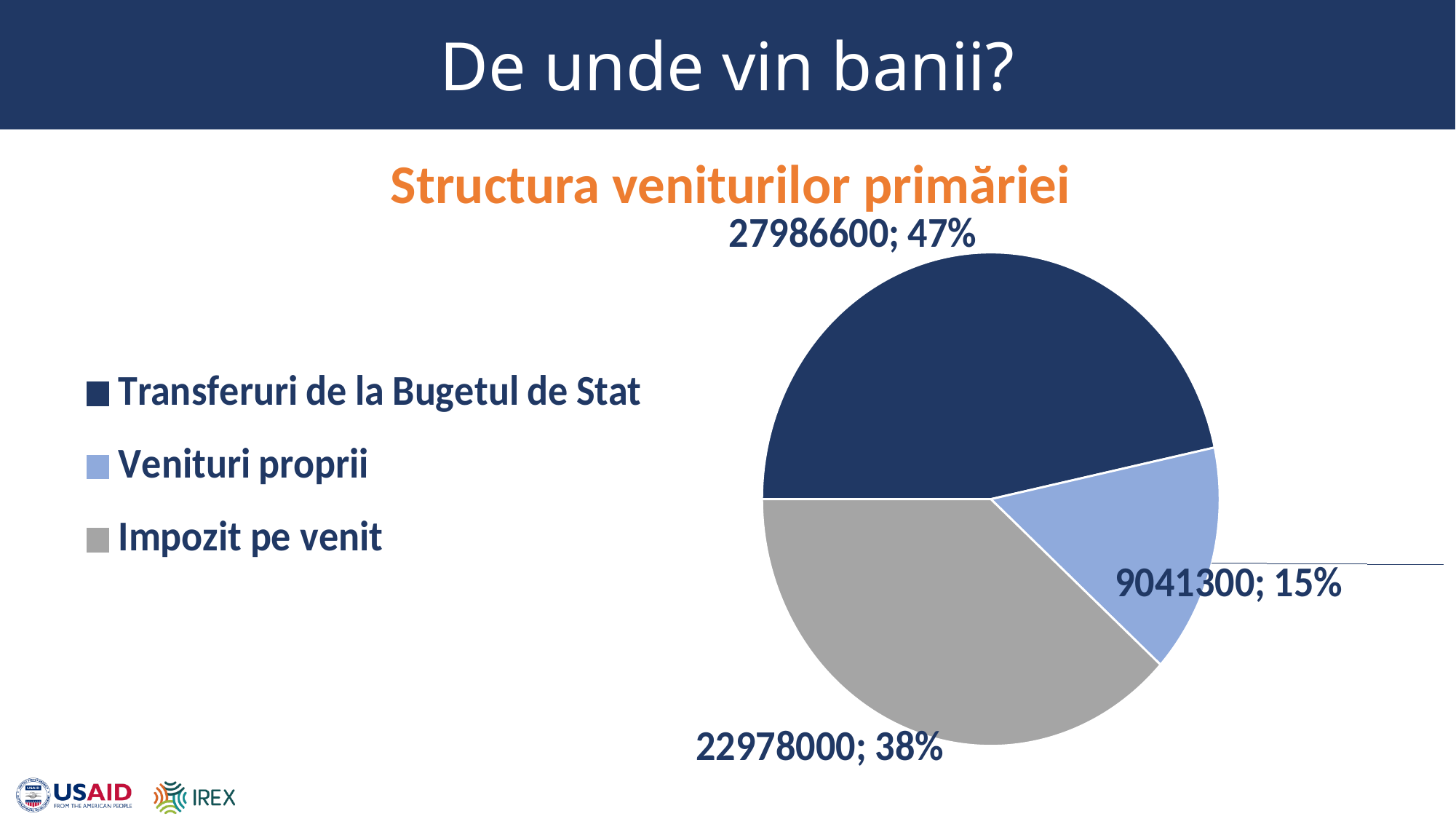
Which is larger, Impozit pe venit or Venituri proprii? Impozit pe venit What share of the pie does Transferuri de la Bugetul de Stat represent? 47% What share of the pie does Impozit pe venit represent? 38% What is the difference between the values for Transferuri de la Bugetul de Stat and Impozit pe venit? 5008600 What type of chart is shown on the slide? Pie chart Which category has the smallest slice? Venituri proprii What is the value for Impozit pe venit? 22978000 How many categories does the pie chart show? 3 What is the value for Transferuri de la Bugetul de Stat? 27986600 What is the value for Venituri proprii? 9041300 What share of the pie does Venituri proprii represent? 15% Which category has the largest slice? Transferuri de la Bugetul de Stat